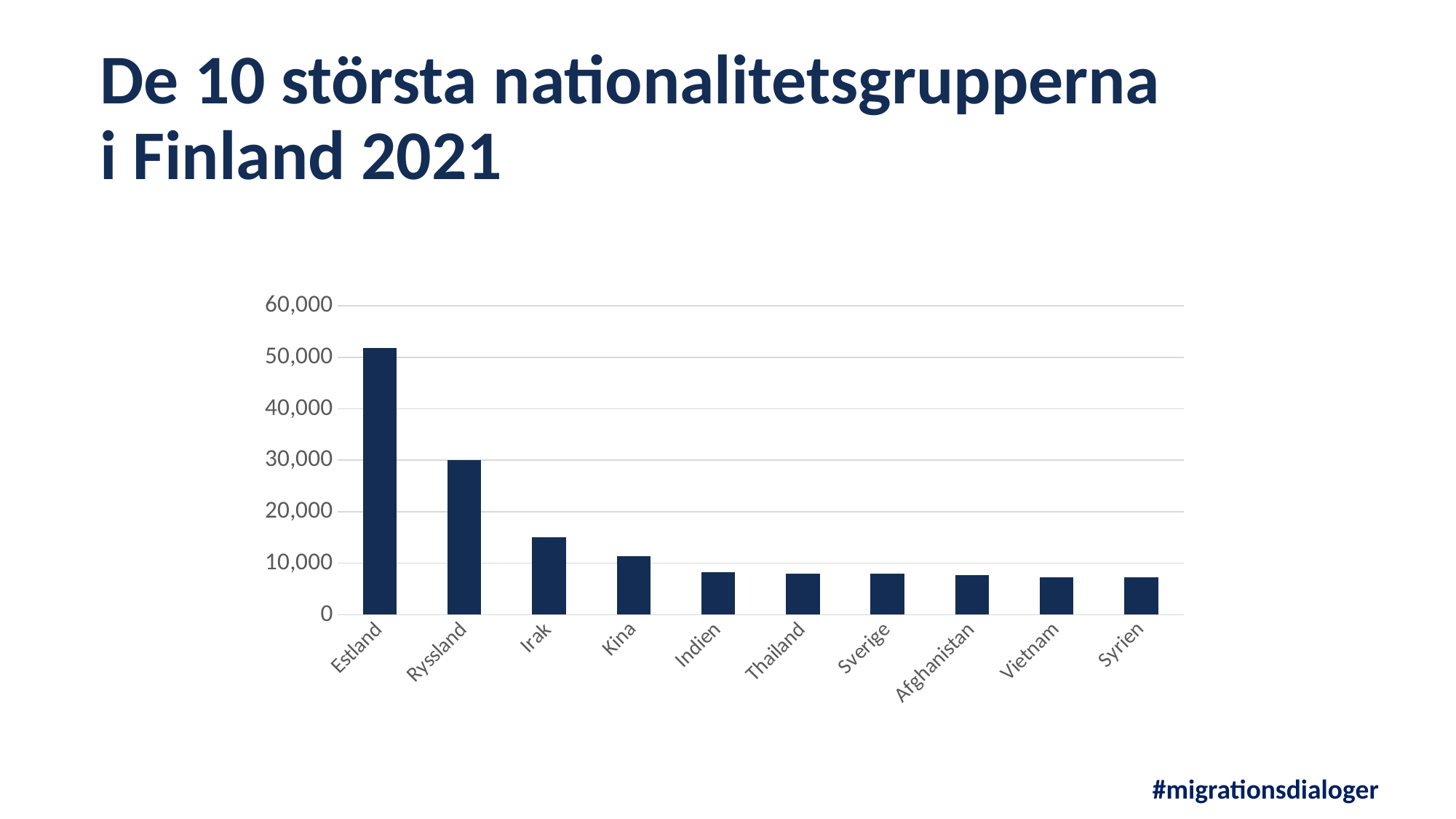
Which has a larger value, Kina or Syrien? Kina What is the title of the slide containing the chart? De 10 största nationalitetsgrupperna i Finland 2021 Do the values rise or fall from left to right along the x axis? fall Is the value for Ryssland greater or less than 40,000? less Is the value for Estland greater or less than 50,000? greater What kind of chart is shown on the slide? bar chart Which nationality group has the highest value in the chart? Estland Which has a larger value, Ryssland or Irak? Ryssland How many nationality groups are shown on the x axis of the chart? 10 Is the value for Kina greater or less than 10,000? greater